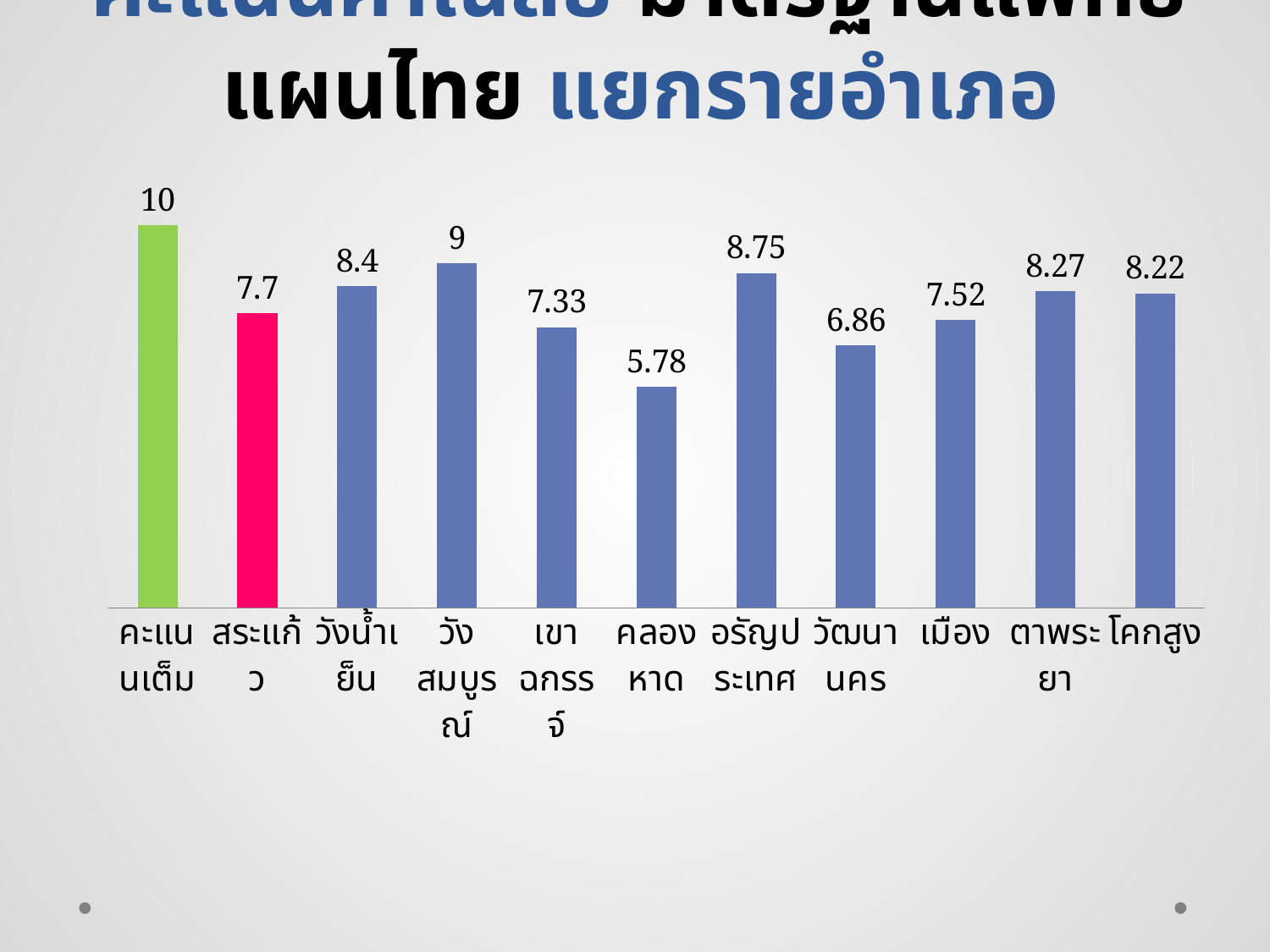
What is the value for อรัญประเทศ? 8.75 Excluding คะแนนเต็ม, which district has the highest value? วังสมบูรณ์ Which is larger, the value for เมือง or the value for ตาพระยา? ตาพระยา How many bars are plotted in the chart? 11 What is the value for วัฒนานคร? 6.86 What type of chart is shown on the slide? bar chart What is the difference between the values for วังสมบูรณ์ and คลองหาด? 3.22 What is the difference between the values for คะแนนเต็ม and สระแก้ว? 2.3 What is the value for คลองหาด? 5.78 What colour is the bar for สระแก้ว? pink Which category has the lowest value? คลองหาด What is the value for สระแก้ว? 7.7